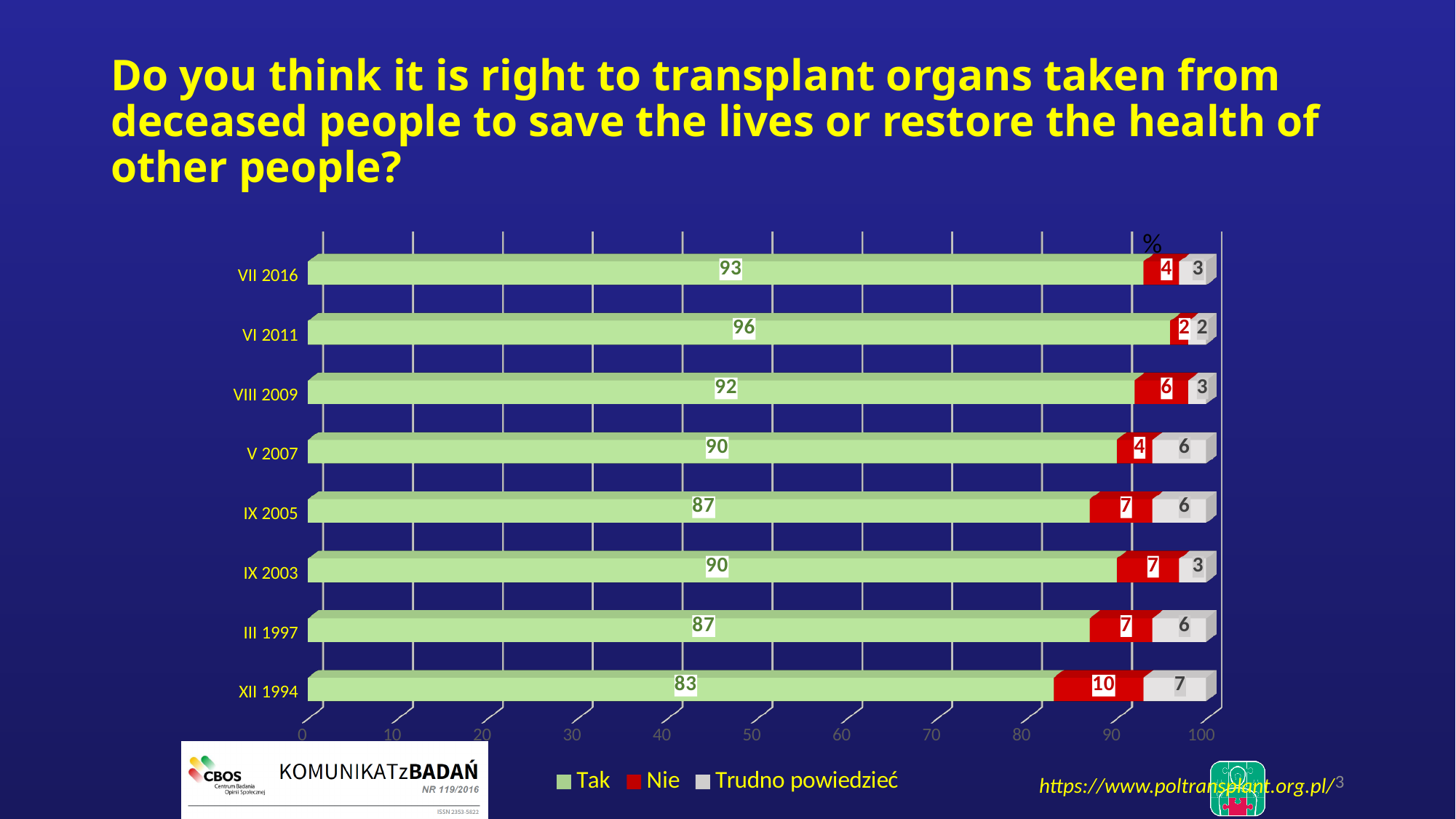
Which colour represents the Nie series in the legend? red What is the total of the stacked bar for IX 2005? 100 Is the Nie value for VIII 2009 larger or smaller than the Nie value for VI 2011? larger What is the value of the Nie series for XII 1994? 10 Which survey date has the lowest Tak value? XII 1994 Which survey date has the highest Tak value? VI 2011 What kind of chart is shown on the slide? stacked bar chart How many series does the legend list? 3 What is the value of the Tak series for VII 2016? 93 How many survey dates are shown on the chart? 8 What is the value of the Trudno powiedzieć series for V 2007? 6 What is the difference between the Tak values for VI 2011 and XII 1994? 13